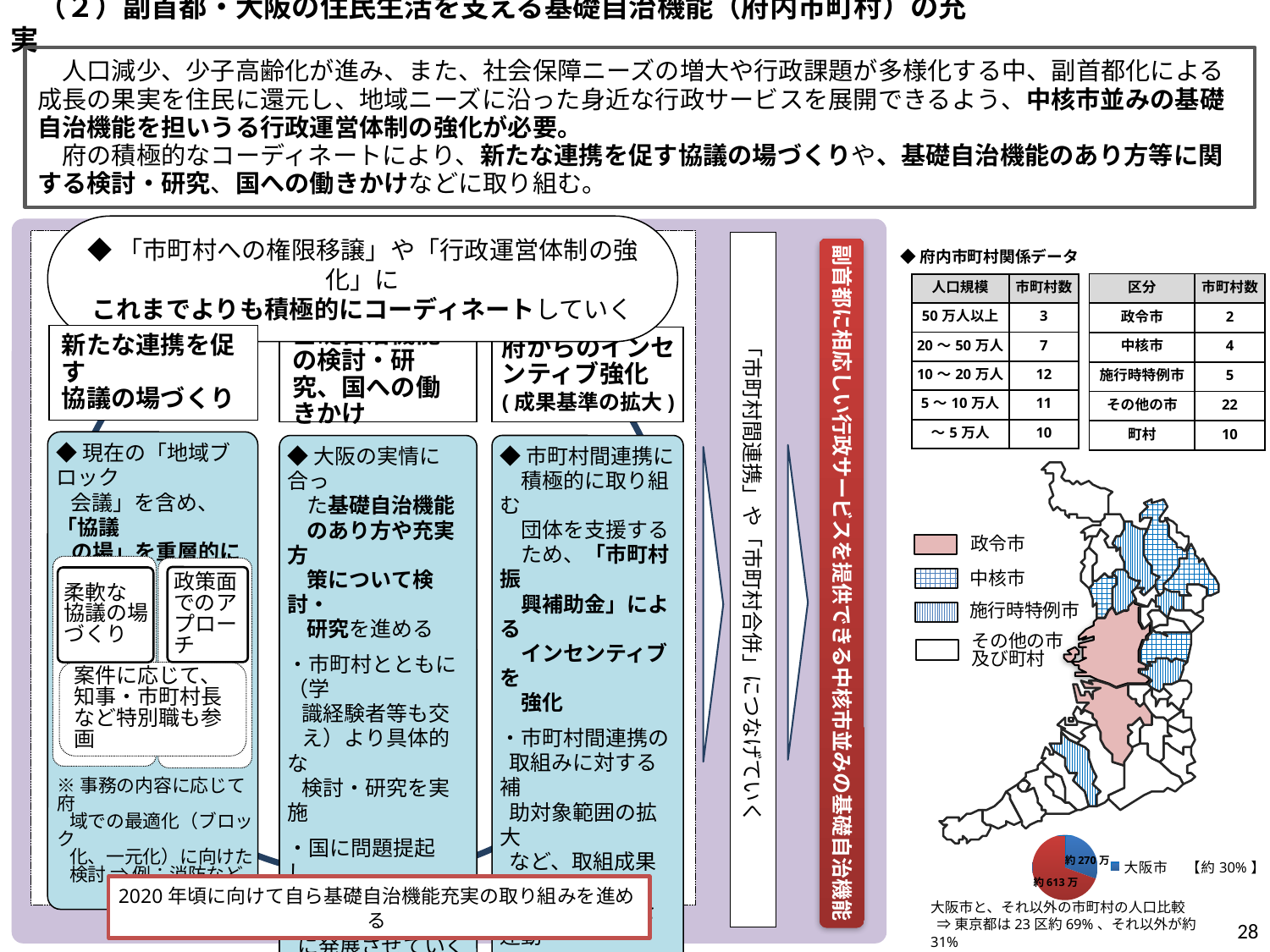
According to the pie chart at the bottom right, what share of the total does 大阪市 account for? 約30% In the pie chart at the bottom right, what value is labelled on the larger slice (the municipalities other than 大阪市)? 約613万 Which category is named in the legend of the pie chart at the bottom right? 大阪市 In the pie chart at the bottom right, what colour is the 大阪市 slice? blue How many slices does the pie chart at the bottom right have? 2 In the pie chart at the bottom right, what value is labelled on the 大阪市 slice? 約270万 What kind of chart is shown at the bottom right of the slide? pie chart In the pie chart at the bottom right, which slice is larger: 大阪市 (約270万) or the other municipalities (約613万)? the other municipalities (約613万) In the pie chart at the bottom right, which slice is the smallest? 大阪市